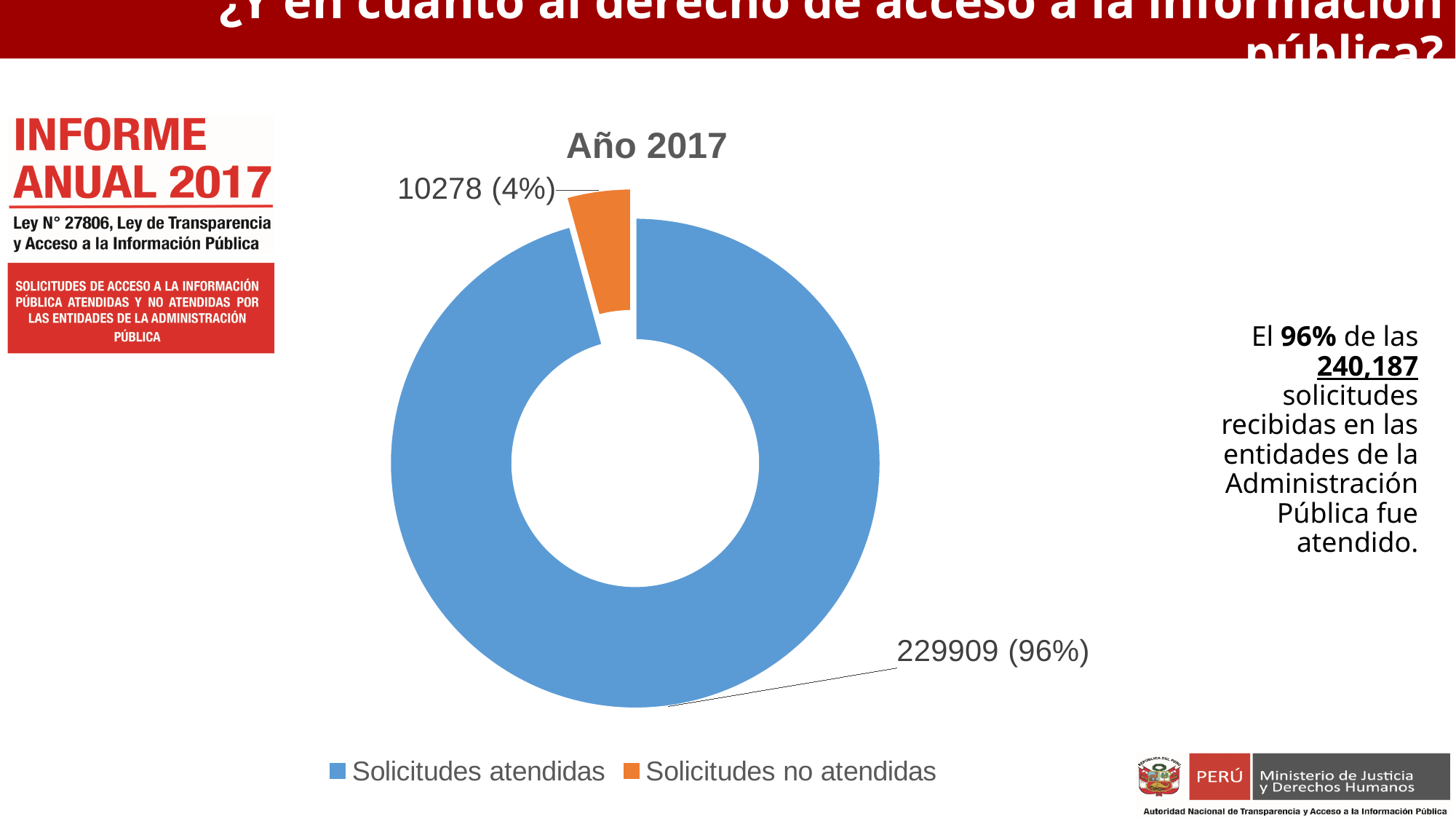
What share of the chart does Solicitudes atendidas represent? 96% What kind of chart is shown on the slide? doughnut chart What is the value for Solicitudes no atendidas? 10278 Which category has the largest slice? Solicitudes atendidas What is the difference between the values for Solicitudes atendidas and Solicitudes no atendidas? 219631 How many slices does the chart have? 2 Which colour represents Solicitudes no atendidas in the chart? orange What is the value for Solicitudes atendidas? 229909 What share of the chart does Solicitudes no atendidas represent? 4% What is the title of the chart? Año 2017 Which category has the smallest slice? Solicitudes no atendidas How many series does the legend list? 2